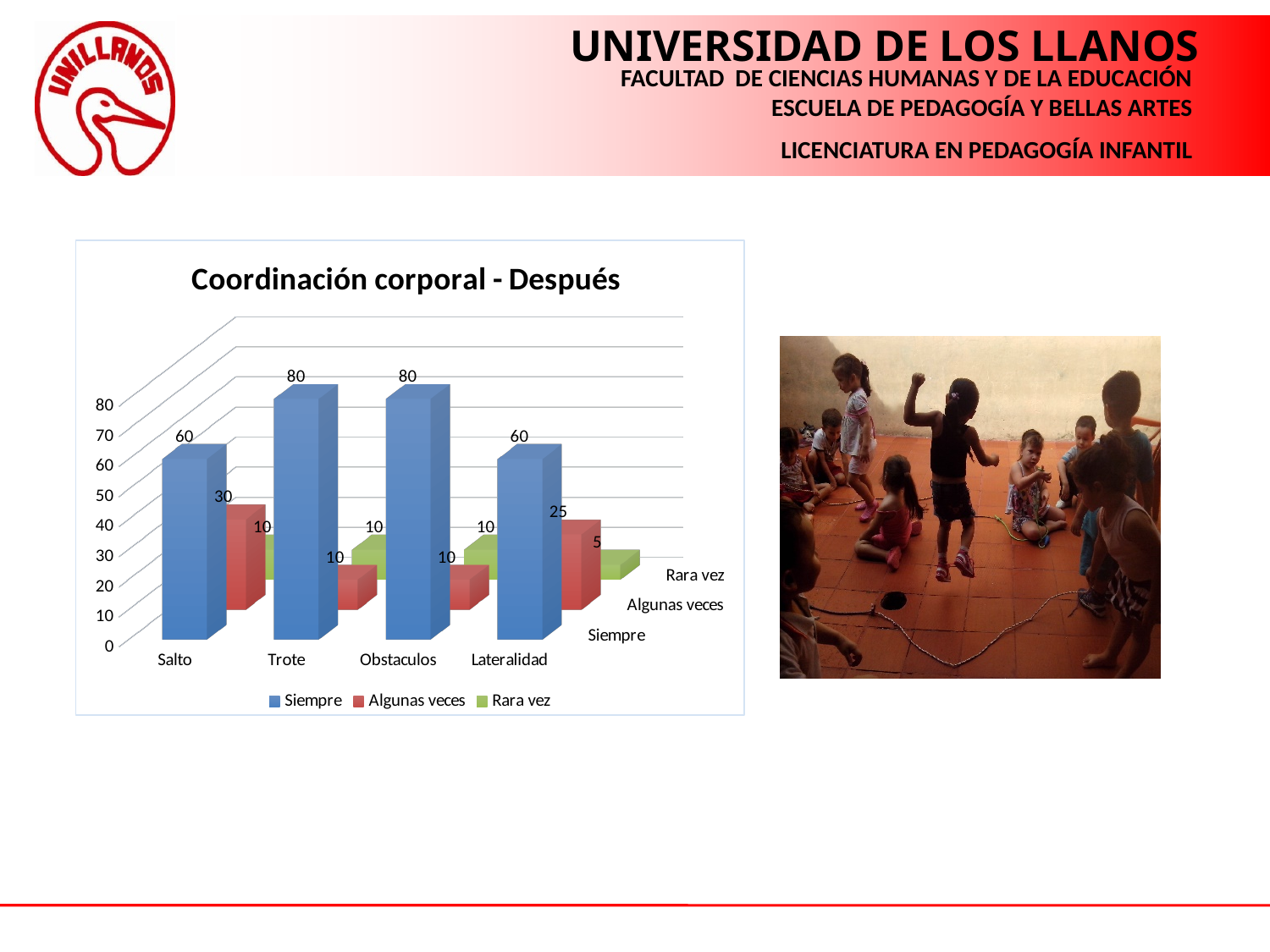
Which category has the highest value for Algunas veces? Salto What is the value for Algunas veces in the Salto category? 30 Which category has the lowest value for Rara vez? Lateralidad What is the value for Rara vez in the Lateralidad category? 5 How many series does the legend list? 3 Which is larger: the Algunas veces value for Salto or for Lateralidad? Salto How many categories are shown on the x axis? 4 What is the title of the chart? Coordinación corporal - Después What is the value for Siempre in the Salto category? 60 What is the value for Algunas veces in the Lateralidad category? 25 What kind of chart is shown? Bar chart What is the difference between the Siempre values for Trote and Salto? 20